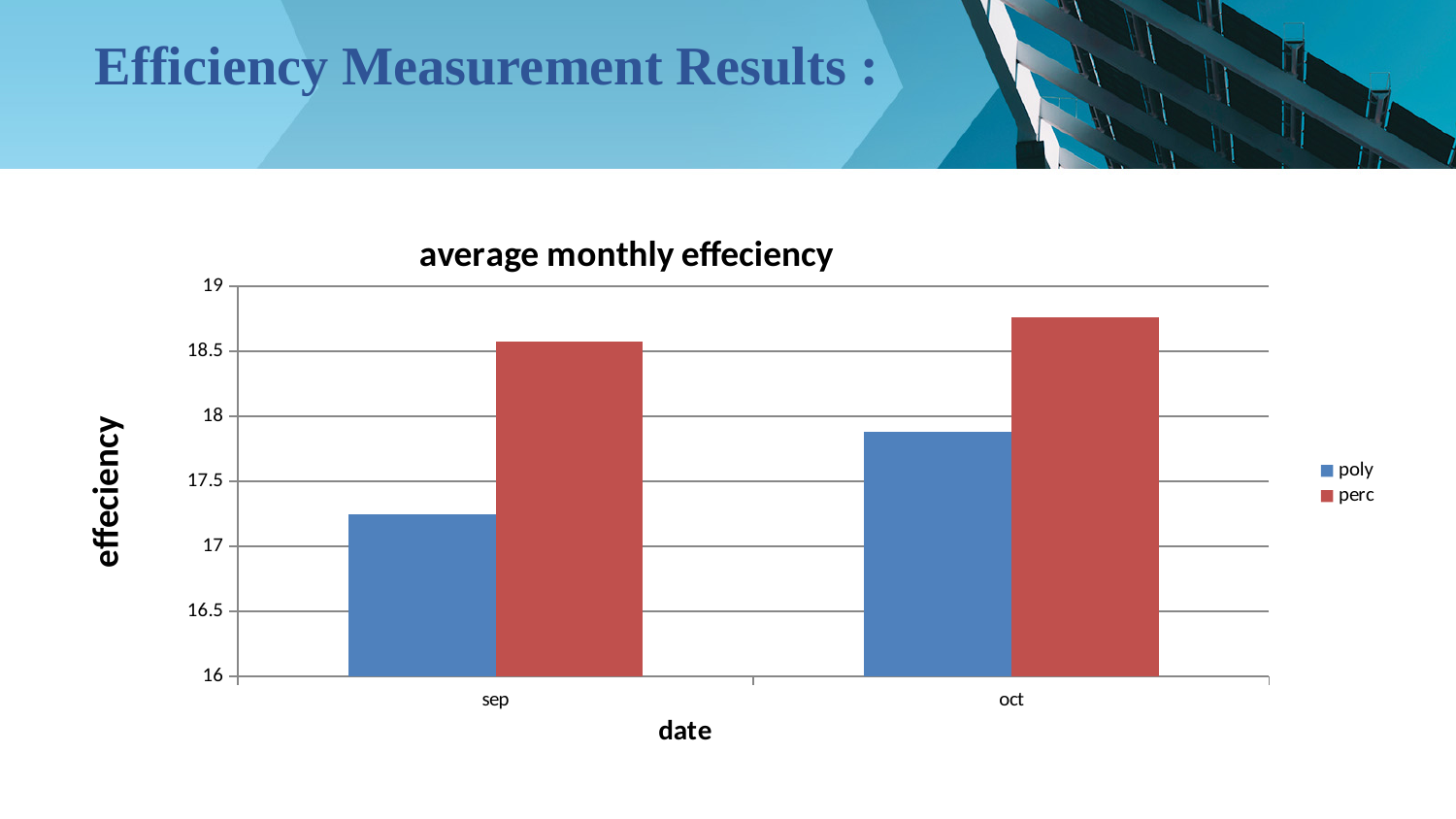
Does the value for poly rise or fall from sep to oct? rise Is the value for poly in sep greater or less than 17? greater Which series is shown in red? perc How many categories are shown on the x axis? 2 Is the value for poly in sep greater or less than 17.5? less Which series has the higher value in sep, poly or perc? perc Is the value for perc in oct greater or less than 18.5? greater How many series does the legend list? 2 What kind of chart is shown on the slide? bar chart Which bar is the highest in the chart? perc in oct What is the title of the chart? average monthly effeciency